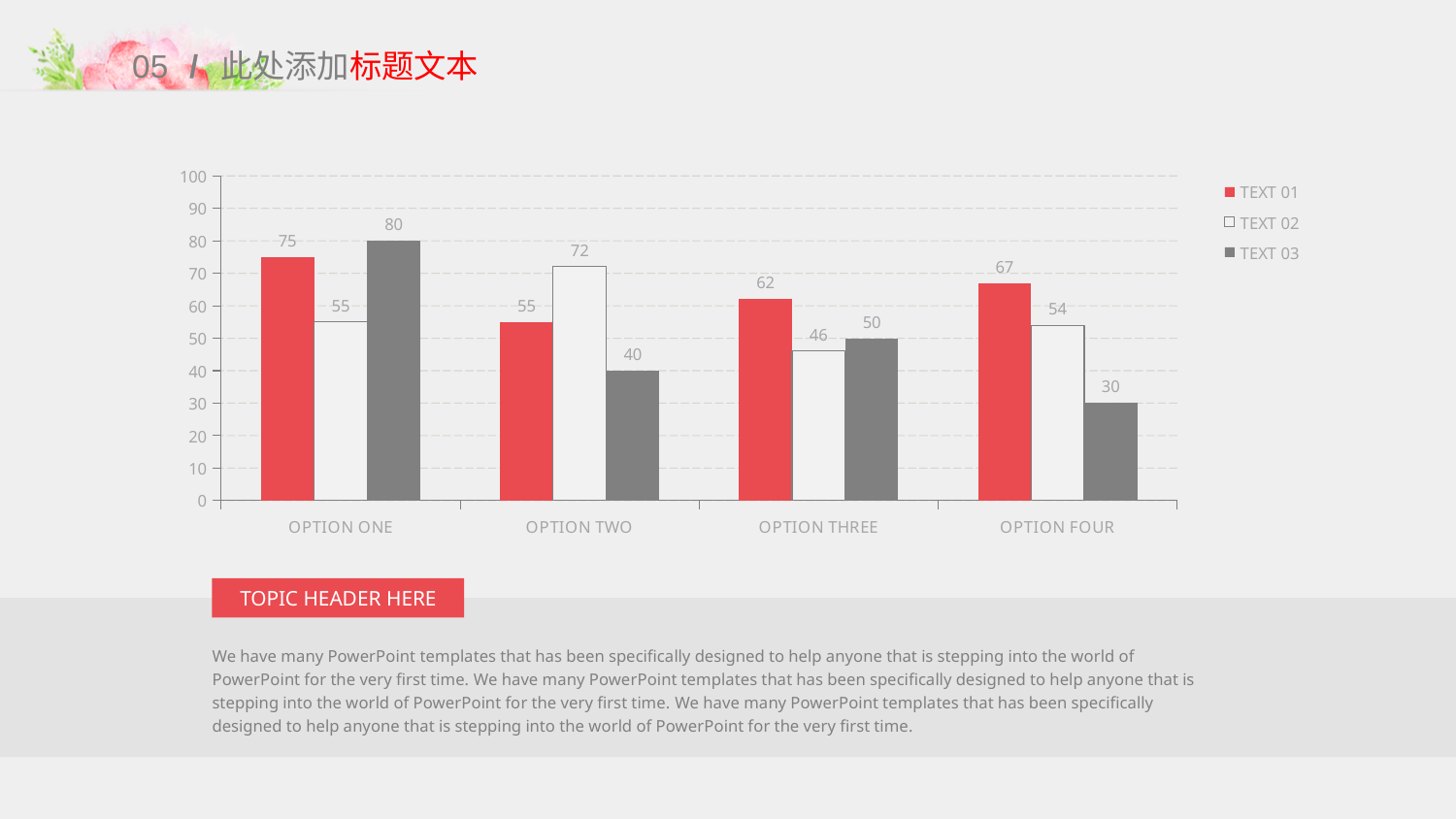
Is the TEXT 02 value for OPTION FOUR greater or less than 60? less What is the difference between the TEXT 01 and TEXT 03 values for OPTION THREE? 12 What colour are the TEXT 01 bars? red Which category has the highest TEXT 03 value? OPTION ONE How many categories are shown on the x axis? 4 What is the value of TEXT 03 for OPTION FOUR? 30 What is the value of TEXT 02 for OPTION TWO? 72 What is the value of TEXT 01 for OPTION ONE? 75 Which category has the lowest TEXT 02 value? OPTION THREE Which is larger for OPTION ONE, TEXT 01 or TEXT 03? TEXT 03 How many series does the legend list? 3 What kind of chart is shown on the slide? bar chart